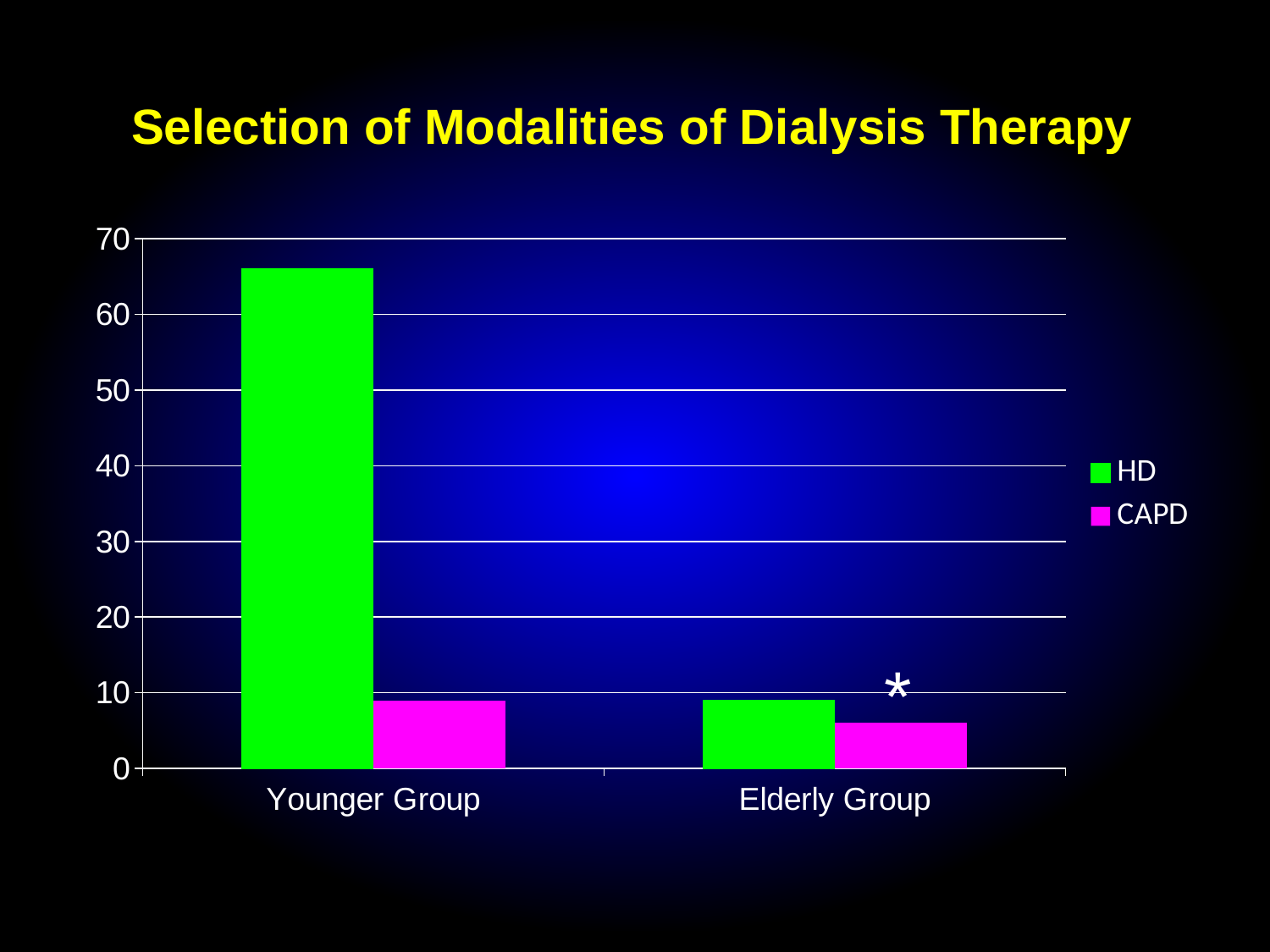
How many series does the legend list? 2 Is the CAPD value for the Younger Group greater or less than 10? less Is the HD value for the Elderly Group greater or less than 10? less What is the title of the chart? Selection of Modalities of Dialysis Therapy Is the HD value for the Younger Group greater or less than 60? greater Which series is shown in green? HD Which bar is the highest in the chart? HD for Younger Group Which bar is the lowest in the chart? CAPD for Elderly Group Which is larger, the HD value for the Younger Group or the HD value for the Elderly Group? Younger Group What kind of chart is shown on the slide? bar chart How many groups are shown on the x axis? 2